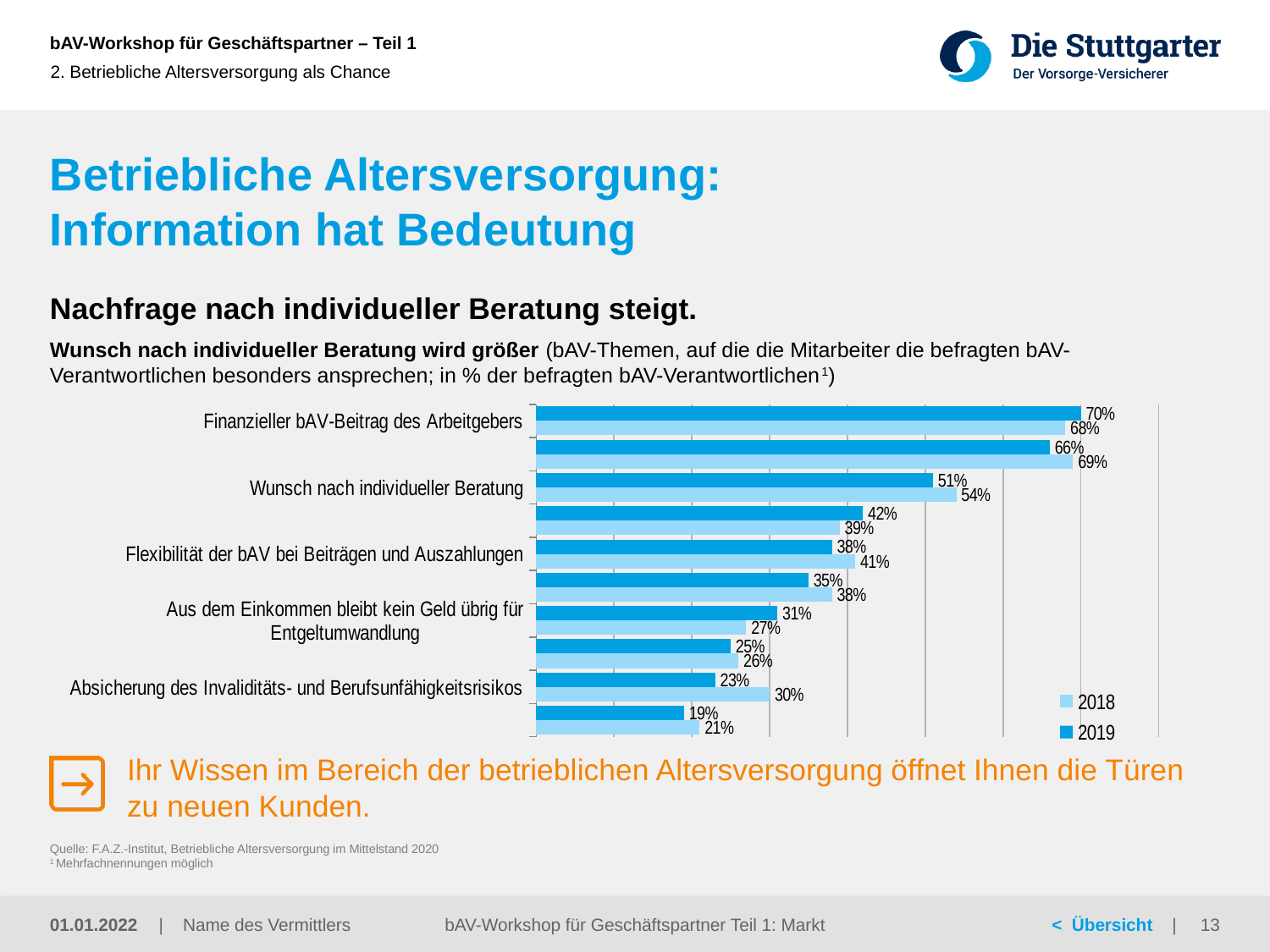
What value is shown on the light blue bar for "Absicherung des Invaliditäts- und Berufsunfähigkeitsrisikos"? 30% What is the difference between the light blue bar (30%) and the dark blue bar (23%) for "Absicherung des Invaliditäts- und Berufsunfähigkeitsrisikos"? 7 percentage points Which two entries appear in the chart legend? 2018 and 2019 What type of chart is shown on the slide? Bar chart What value is shown on the light blue bar for "Wunsch nach individueller Beratung"? 54% How many series does the chart legend list? 2 What value is shown on the light blue bar for "Finanzieller bAV-Beitrag des Arbeitgebers"? 68% What value is shown on the dark blue bar for "Wunsch nach individueller Beratung"? 51% What value is shown on the dark blue bar for "Finanzieller bAV-Beitrag des Arbeitgebers"? 70% Which labelled category has the highest value in the chart? Finanzieller bAV-Beitrag des Arbeitgebers What value is shown on the light blue bar for "Flexibilität der bAV bei Beiträgen und Auszahlungen"? 41% What value is shown on the dark blue bar for "Aus dem Einkommen bleibt kein Geld übrig für Entgeltumwandlung"? 31%